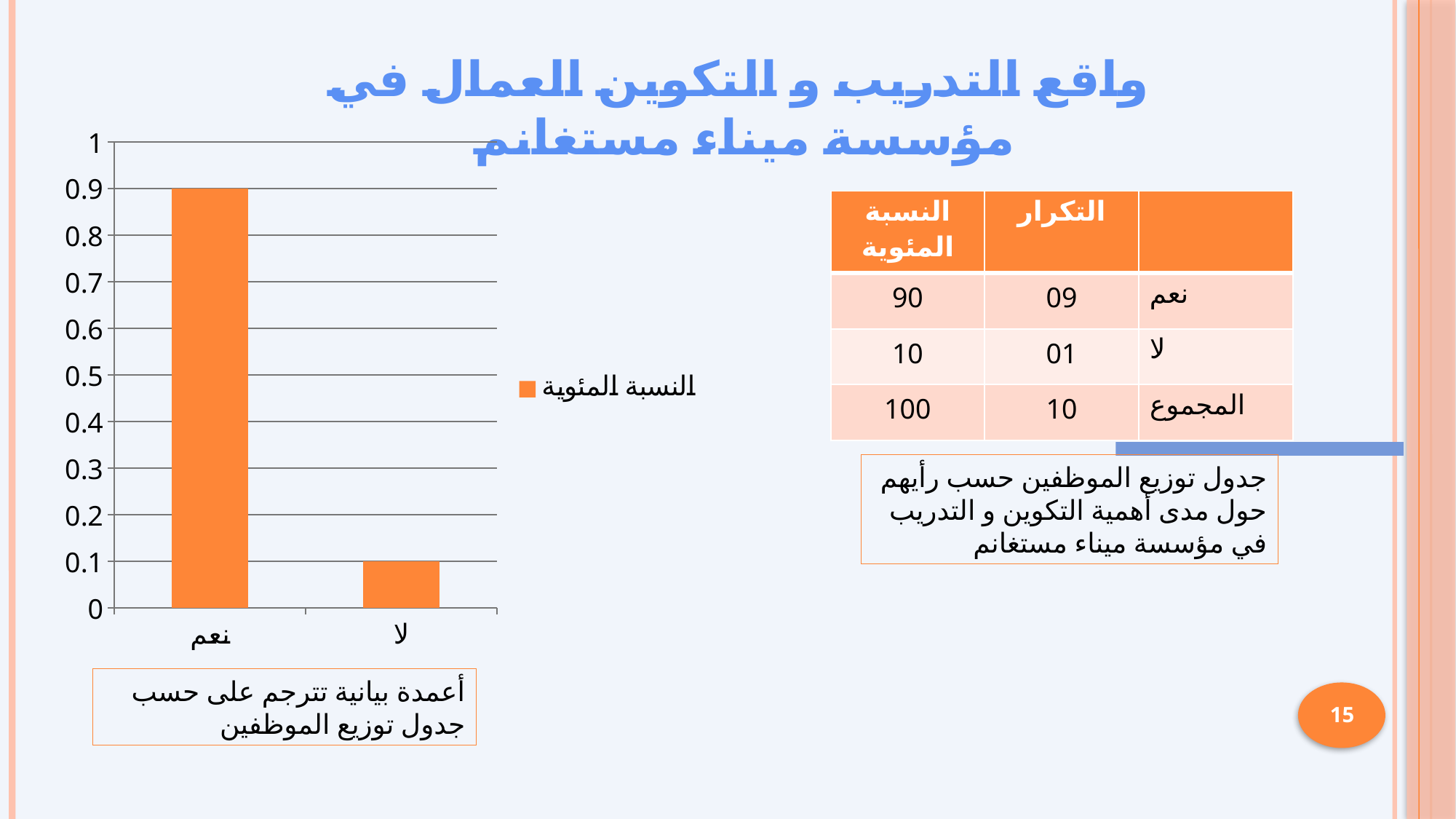
What is the value of the bar for نعم? 0.9 What type of chart is shown on the slide? bar chart How many series does the chart legend list? 1 Which category has the lowest bar? لا What is the name of the series shown in the chart legend? النسبة المئوية Is the value for نعم greater or less than 0.5? greater What is the difference between the values for نعم and لا? 0.8 Is the value for لا greater or less than 0.5? less How many categories are shown on the x axis of the chart? 2 Which is larger, the value for نعم or the value for لا? نعم Which category has the highest bar? نعم What is the value of the bar for لا? 0.1